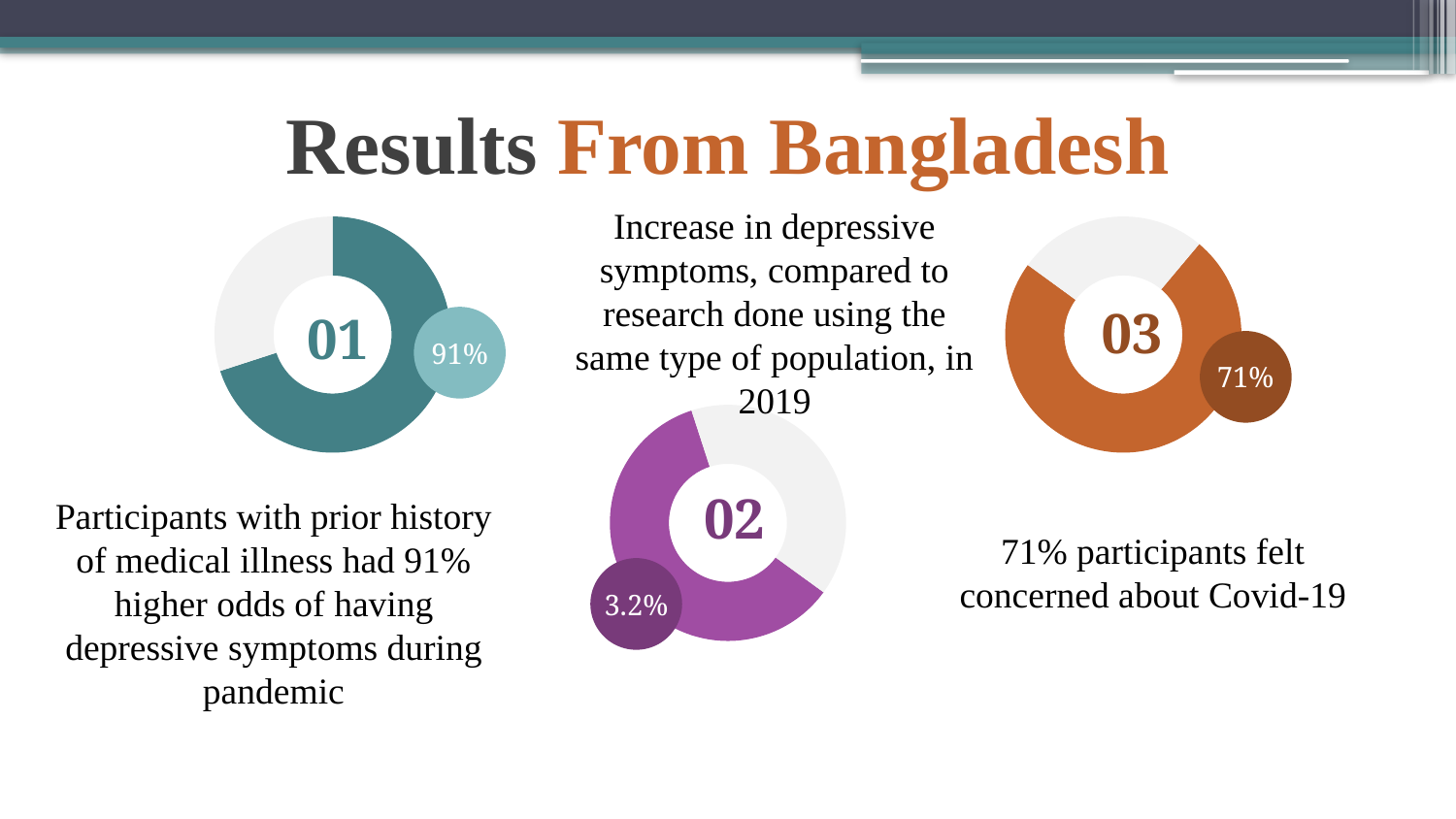
What colour is the filled ring of the middle donut chart labelled 02? Purple What value is printed next to the right donut chart labelled 03? 71% What value is printed next to the middle donut chart labelled 02? 3.2% What is the difference between the printed values of chart 01 and chart 03? 20% How many donut charts are shown on the slide? 3 What value is printed next to the left donut chart labelled 01? 91% What is the title of the slide containing the three donut charts? Results From Bangladesh Which of the three donut charts shows the highest printed percentage? 01 (91%) Is the printed value for chart 01 larger or smaller than the printed value for chart 03? larger What kind of chart is used for the three figures on the slide? Donut (pie) chart Is the printed value for chart 03 greater or less than 50%? greater Which of the three donut charts shows the lowest printed percentage? 02 (3.2%)